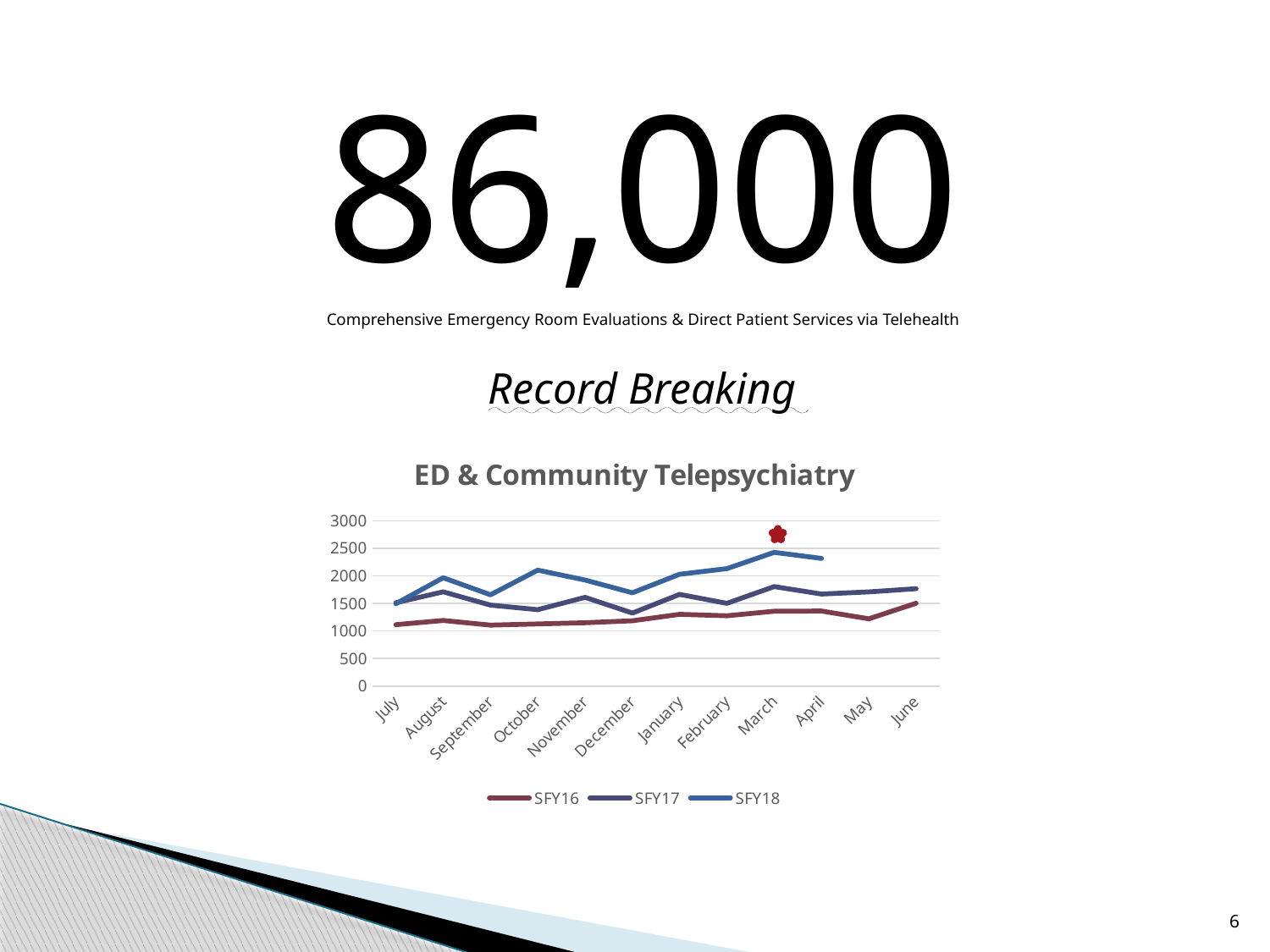
What type of chart is shown on the slide? line chart How many months are shown on the x axis of the chart? 12 Is the SFY16 value for July greater or less than 1500? less In which month does the SFY18 series reach its highest value? March How many series does the chart legend list? 3 Is the SFY18 value for March greater or less than 2000? greater Is the SFY18 value for December greater or less than 2000? less Which series are listed in the chart legend? SFY16, SFY17, SFY18 In March, which series has the higher value, SFY16 or SFY18? SFY18 Which series has the highest value in March? SFY18 What is the title of the chart? ED & Community Telepsychiatry